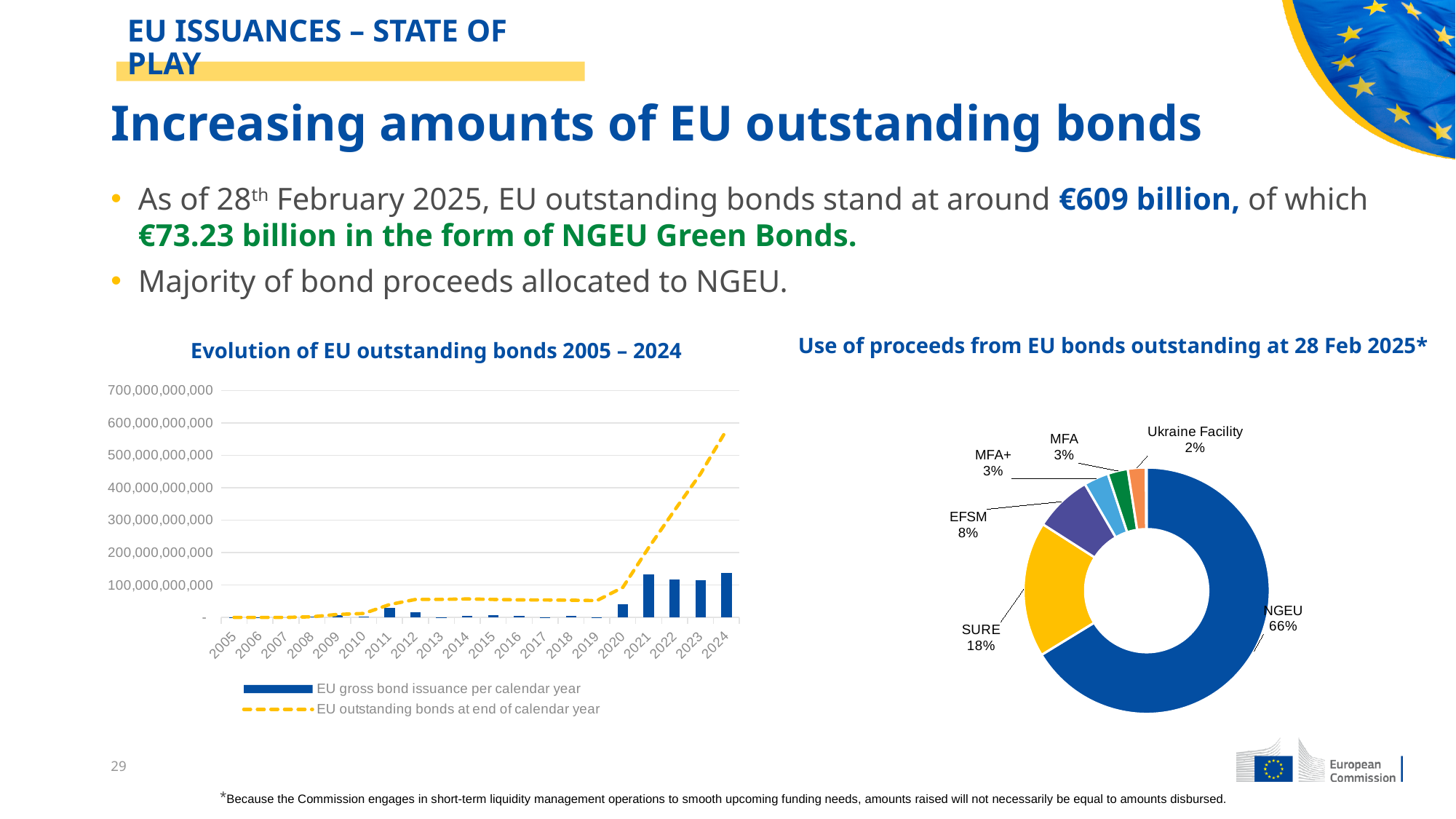
In the 'Use of proceeds from EU bonds outstanding at 28 Feb 2025' chart, which category has the largest share? NGEU In the 'Use of proceeds from EU bonds outstanding at 28 Feb 2025' chart, how many categories are shown? 6 In the 'Use of proceeds from EU bonds outstanding at 28 Feb 2025' chart, what share of proceeds goes to the Ukraine Facility? 2% In the 'Evolution of EU outstanding bonds 2005 – 2024' chart, is the value of EU outstanding bonds at end of 2024 greater or less than 500,000,000,000? greater In the 'Evolution of EU outstanding bonds 2005 – 2024' chart, does the EU outstanding bonds line rise or fall from 2019 to 2024? rise In the 'Use of proceeds from EU bonds outstanding at 28 Feb 2025' chart, what is the difference in percentage points between the SURE share and the EFSM share? 10 percentage points In the 'Evolution of EU outstanding bonds 2005 – 2024' chart, how many series does the legend list? 2 In the 'Use of proceeds from EU bonds outstanding at 28 Feb 2025' chart, what share of proceeds goes to SURE? 18% In the 'Evolution of EU outstanding bonds 2005 – 2024' chart, how many years are shown on the x axis? 20 In the 'Use of proceeds from EU bonds outstanding at 28 Feb 2025' chart, what share of proceeds goes to NGEU? 66% What kind of chart is 'Use of proceeds from EU bonds outstanding at 28 Feb 2025'? Donut (pie) chart